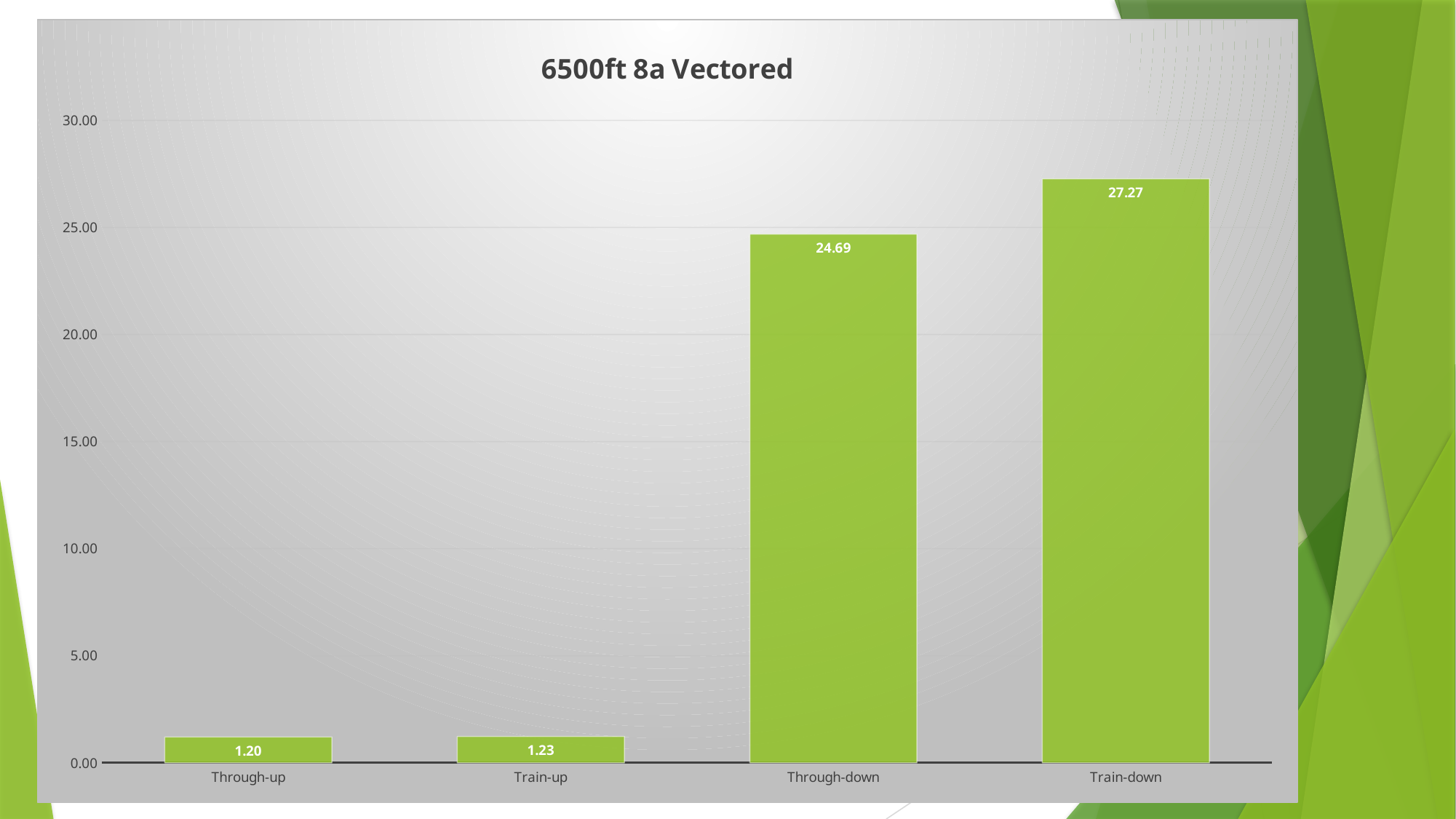
What is the title of the chart? 6500ft 8a Vectored Is the value for Through-down greater or less than 20.00? greater What is the difference between the values for Train-down and Through-down? 2.58 Which is larger, the value for Through-down or the value for Train-down? Train-down What kind of chart is shown on the slide? bar chart Which category has the highest value? Train-down What is the value for Through-up? 1.20 What is the value for Train-up? 1.23 What is the difference between the values for Train-up and Through-up? 0.03 What is the value for Train-down? 27.27 What is the value for Through-down? 24.69 How many categories are shown on the x axis? 4